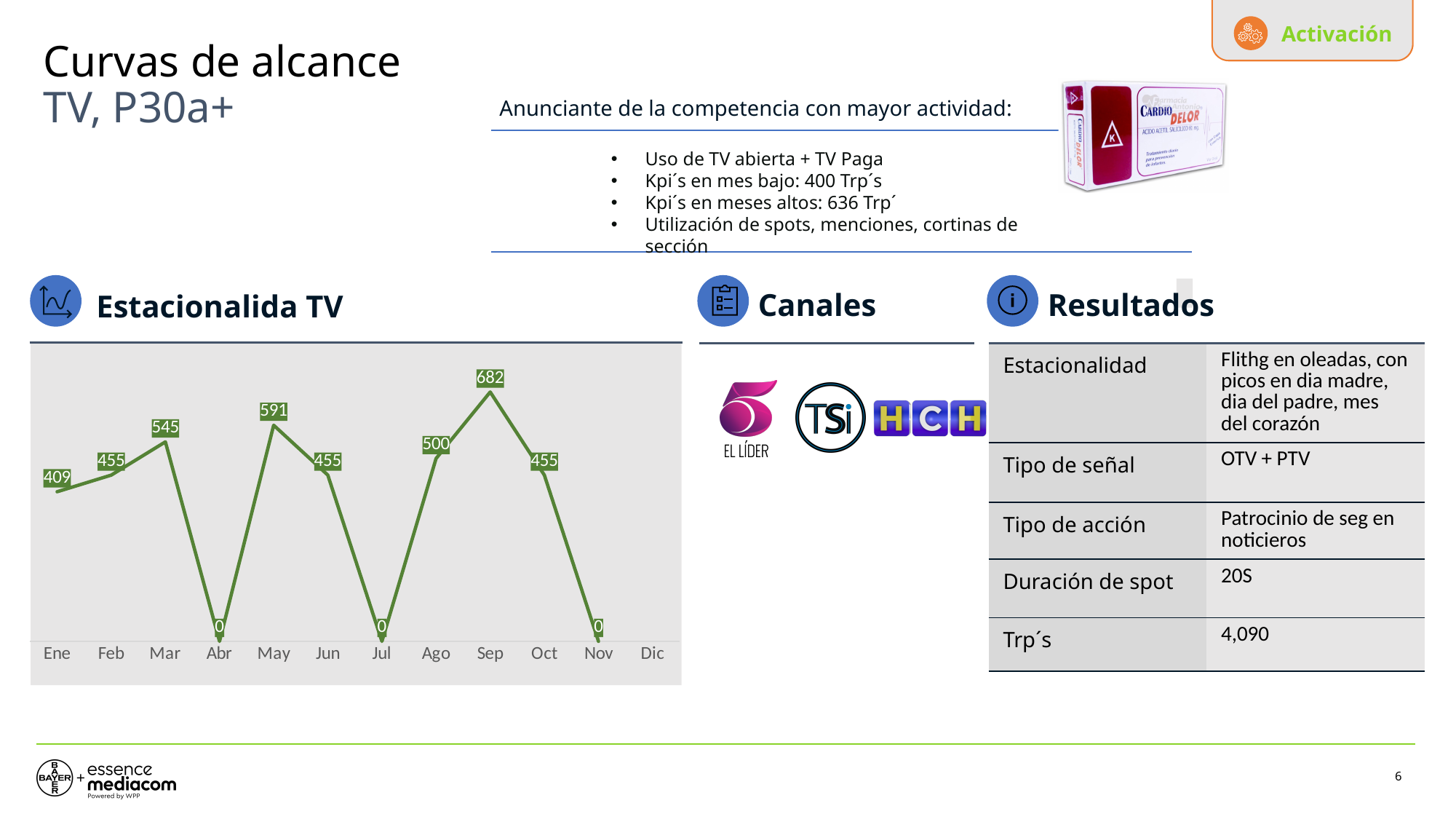
What is the value for Ene in the Estacionalida TV chart? 409 What is the difference between the values for Sep and May in the Estacionalida TV chart? 91 What type of chart is shown under "Estacionalida TV"? line chart What is the difference between the values for Mar and Feb in the Estacionalida TV chart? 90 Which months have a value of 0 in the Estacionalida TV chart? Abr, Jul, Nov Which is larger in the Estacionalida TV chart, the value for Mar or the value for Ago? Mar What is the value for May in the Estacionalida TV chart? 591 Which month has the highest value in the Estacionalida TV chart? Sep Does the value rise or fall from Ene to Mar in the Estacionalida TV chart? rise How many month labels are shown on the x axis of the Estacionalida TV chart? 12 What is the value for Ago in the Estacionalida TV chart? 500 What is the value for Sep in the Estacionalida TV chart? 682